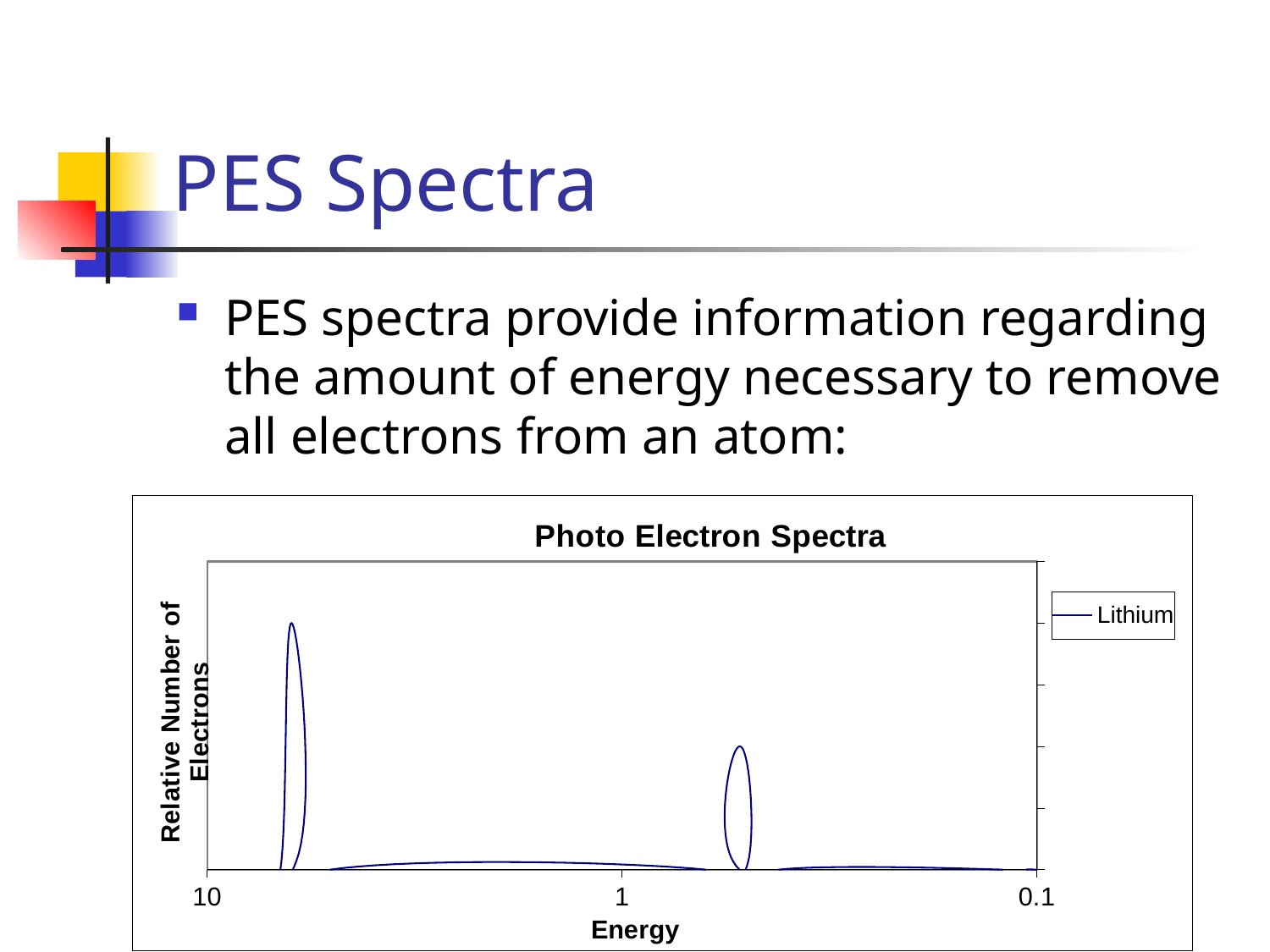
What is the label of the x axis of the chart? Energy What kind of chart is shown on the slide? line chart What is the label of the y axis of the chart? Relative Number of Electrons How many peaks does the Lithium spectrum show in the chart? 2 How many series does the chart's legend list? 1 What is the title of the chart on the slide? Photo Electron Spectra What is the leftmost tick label on the x axis of the chart? 10 Which element is named in the chart's legend? Lithium Is the energy of the tallest peak in the chart greater or less than 1? greater What is the rightmost tick label on the x axis of the chart? 0.1 Which peak in the Lithium spectrum is taller: the one at higher energy (left) or the one at lower energy (right)? the one at higher energy (left) Is the energy of the shorter peak in the chart greater or less than 1? less